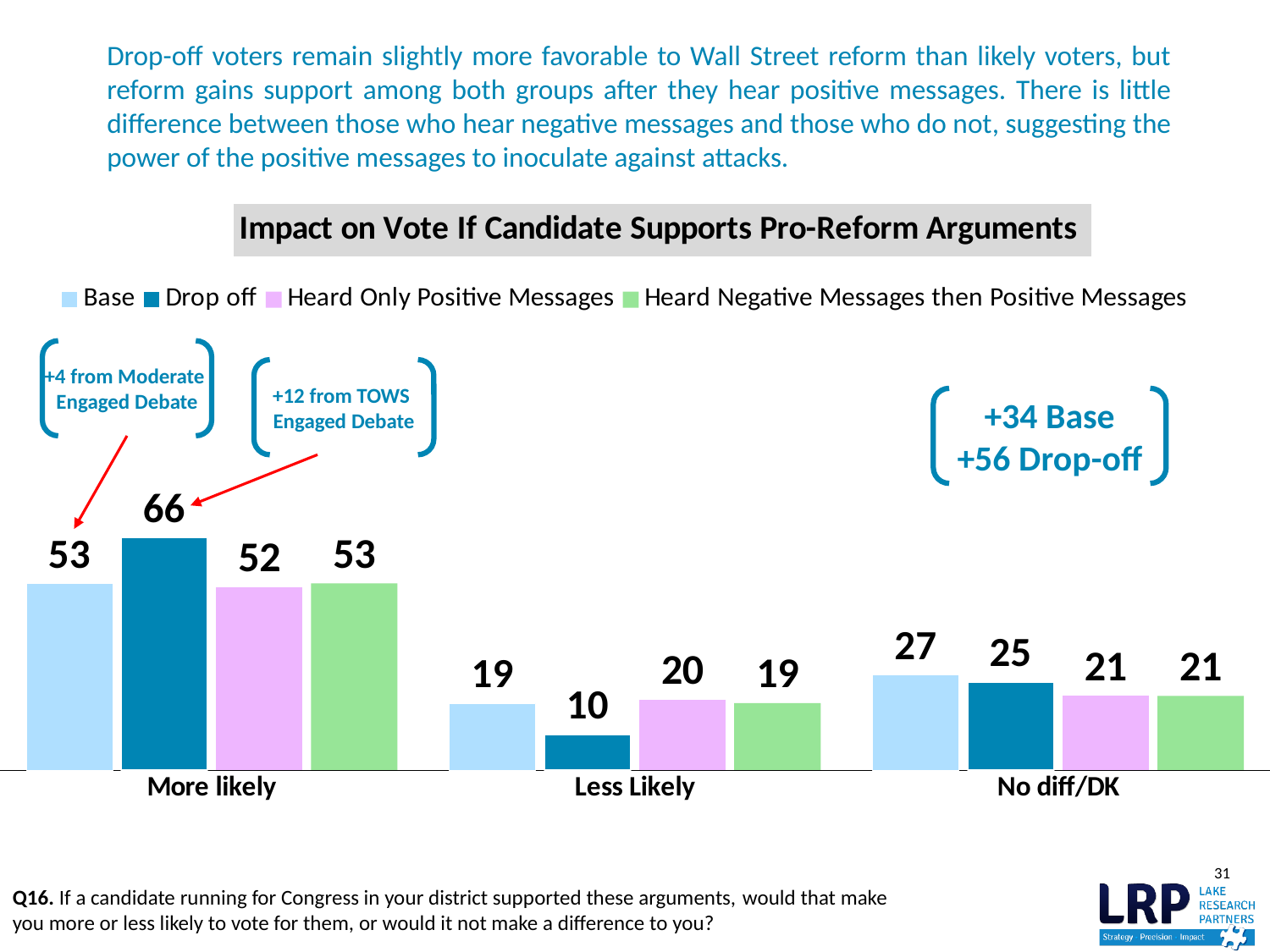
What kind of chart is shown on the slide? Bar chart Which is larger: the Base value for No diff/DK or the Drop off value for No diff/DK? Base Which series has the lowest value in the Less Likely category? Drop off What is the value for Drop off in the More likely category? 66 What is the difference between the Base and Drop off values in the Less Likely category? 9 How many series does the legend list? 4 What is the title of the chart? Impact on Vote If Candidate Supports Pro-Reform Arguments What is the value for Heard Only Positive Messages in the No diff/DK category? 21 How many categories are shown on the x axis? 3 Which series has the highest value in the More likely category? Drop off What is the difference between the Drop off and Base values in the More likely category? 13 What is the value for Base in the Less Likely category? 19